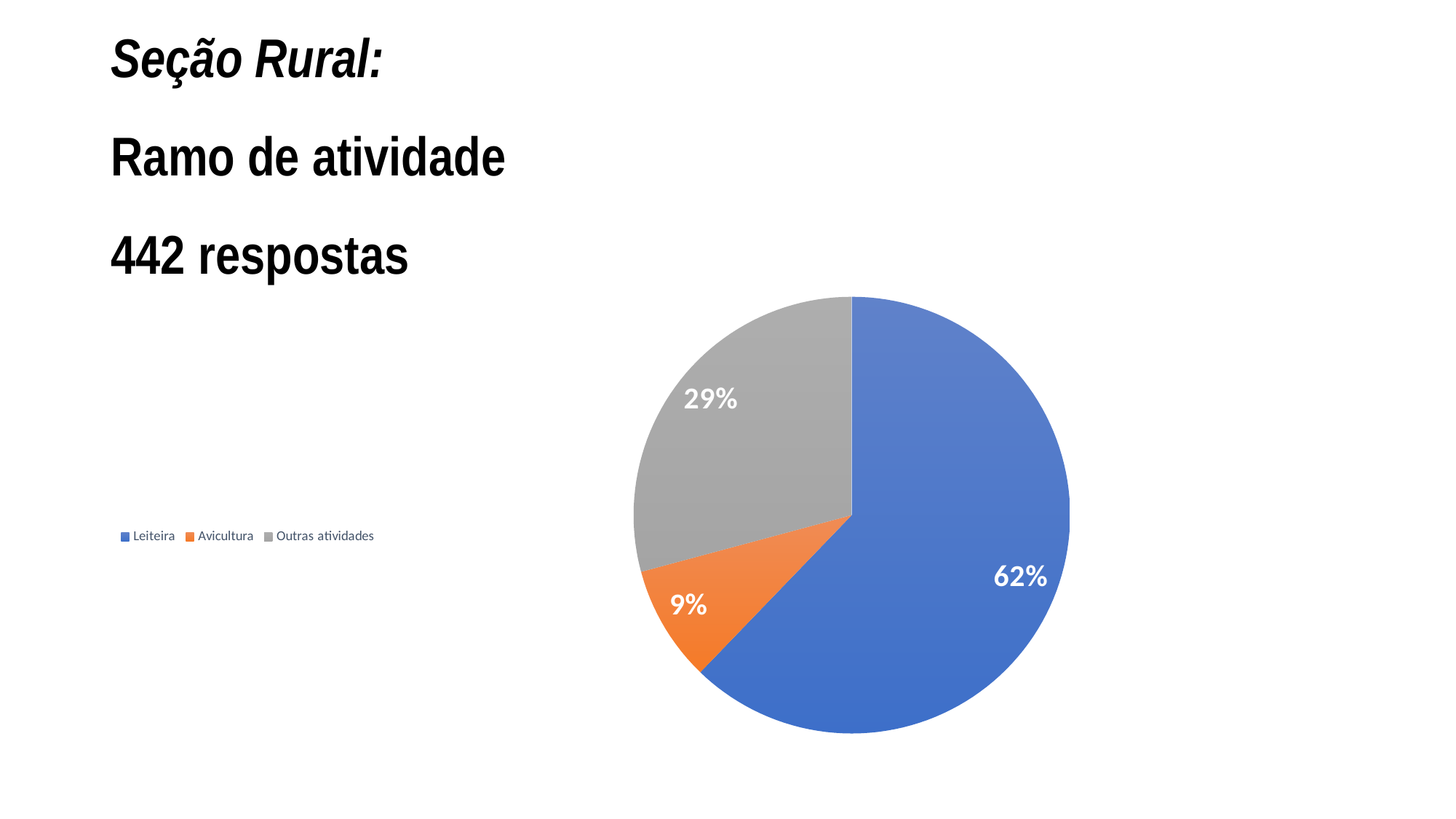
What share of the pie does Outras atividades represent? 29% Which is larger, the slice for Avicultura or the slice for Outras atividades? Outras atividades What is the difference in percentage points between Leiteira and Outras atividades? 33 How many categories does the pie chart show? 3 What share of the pie does Leiteira represent? 62% Which category has the smallest slice of the pie? Avicultura What is the difference in percentage points between Outras atividades and Avicultura? 20 How many entries does the legend list? 3 What share of the pie does Avicultura represent? 9% What kind of chart is shown on the slide? pie chart Which category has the largest slice of the pie? Leiteira What colour is the slice for Avicultura? orange